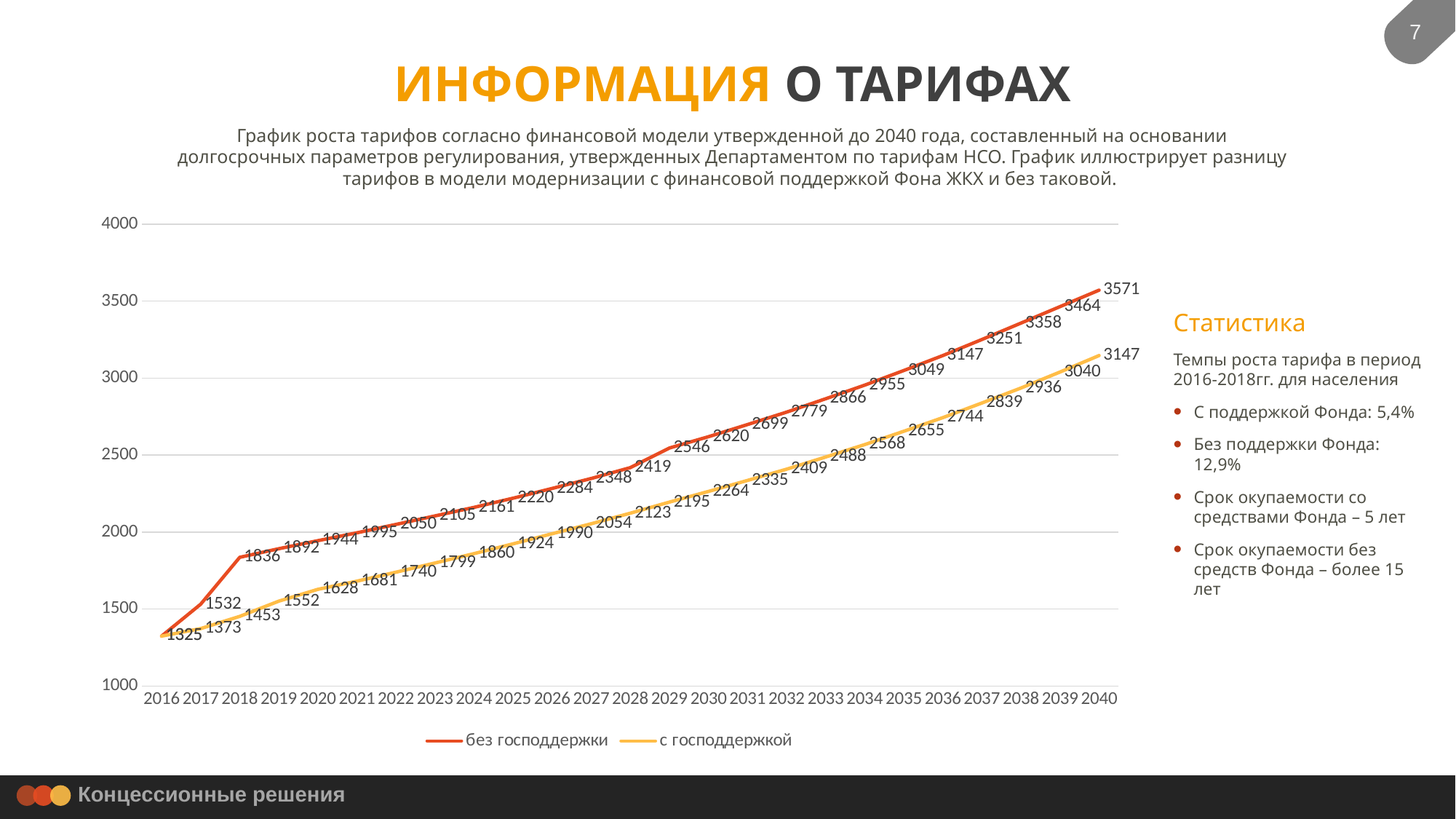
What is the value for 'с господдержкой' in 2040? 3147 What is the value for 'без господдержки' in 2018? 1836 Do the values of 'с господдержкой' rise or fall from 2016 to 2040? rise What is the difference between 'без господдержки' and 'с господдержкой' in 2040? 424 In which year does 'без господдержки' reach its highest value? 2040 How many series does the legend list? 2 What is the difference between 'без господдержки' and 'с господдержкой' in 2028? 296 In 2025, which series has the higher value, 'без господдержки' or 'с господдержкой'? без господдержки How many years are plotted along the x axis? 25 What kind of chart is shown on the slide? line chart What is the value for 'с господдержкой' in 2030? 2264 What is the value for 'без господдержки' in 2040? 3571